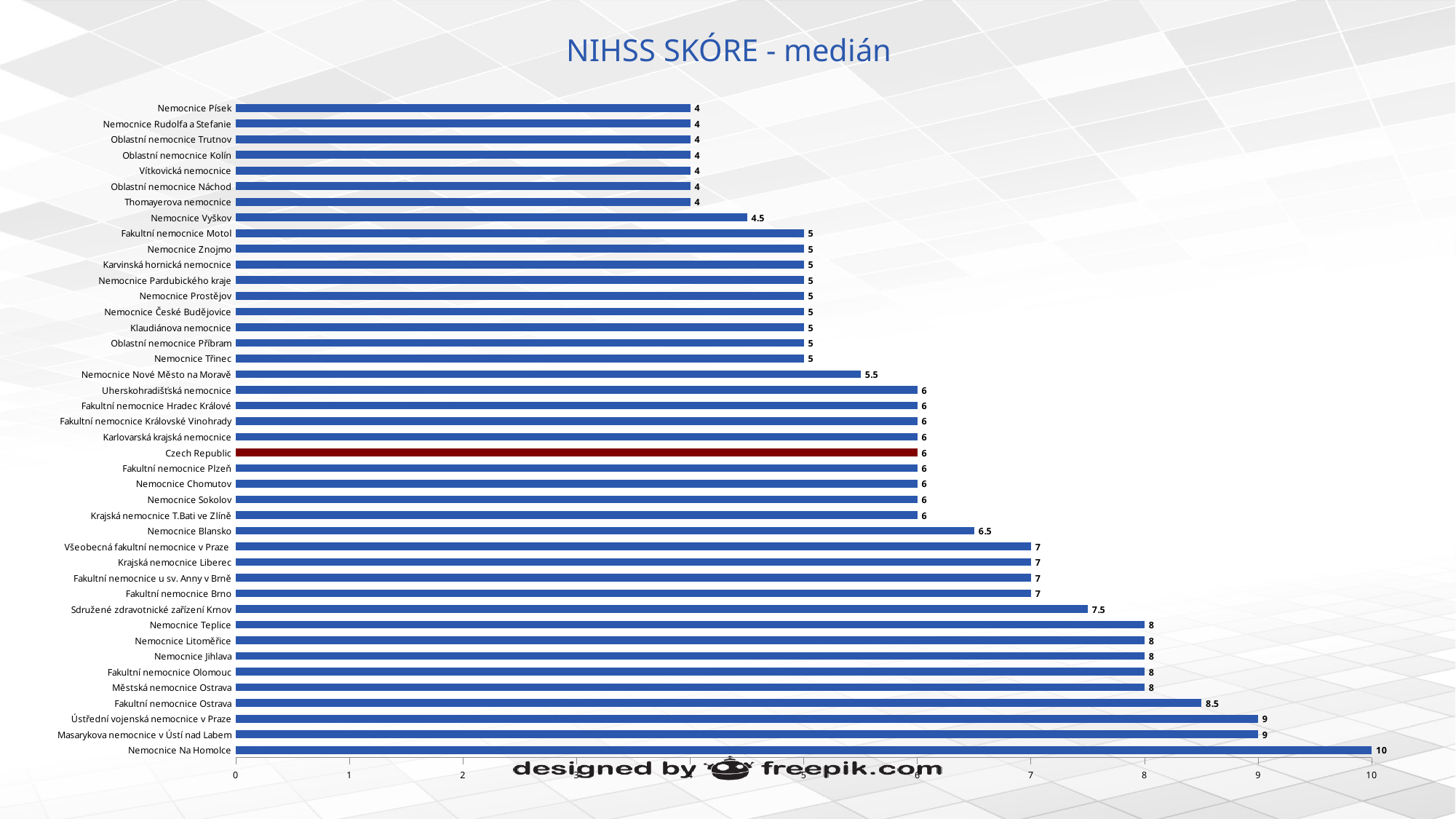
What is the value for Nemocnice Vyškov? 4.5 What is the value for Fakultní nemocnice Ostrava? 8.5 Which hospital has the highest NIHSS median score? Nemocnice Na Homolce What type of chart is shown on the slide? bar chart What is the title of the chart? NIHSS SKÓRE - medián What is the value for Nemocnice Na Homolce? 10 How many bars are plotted in the chart? 42 Which is larger, the value for Nemocnice Blansko or the value for Nemocnice Třinec? Nemocnice Blansko What is the NIHSS median score for Czech Republic? 6 What is the difference between the values for Sdružené zdravotnické zařízení Krnov and Nemocnice Nové Město na Moravě? 2 Which bar is shown in a different colour (dark red) from the others? Czech Republic What is the difference between the values for Nemocnice Na Homolce and Czech Republic? 4